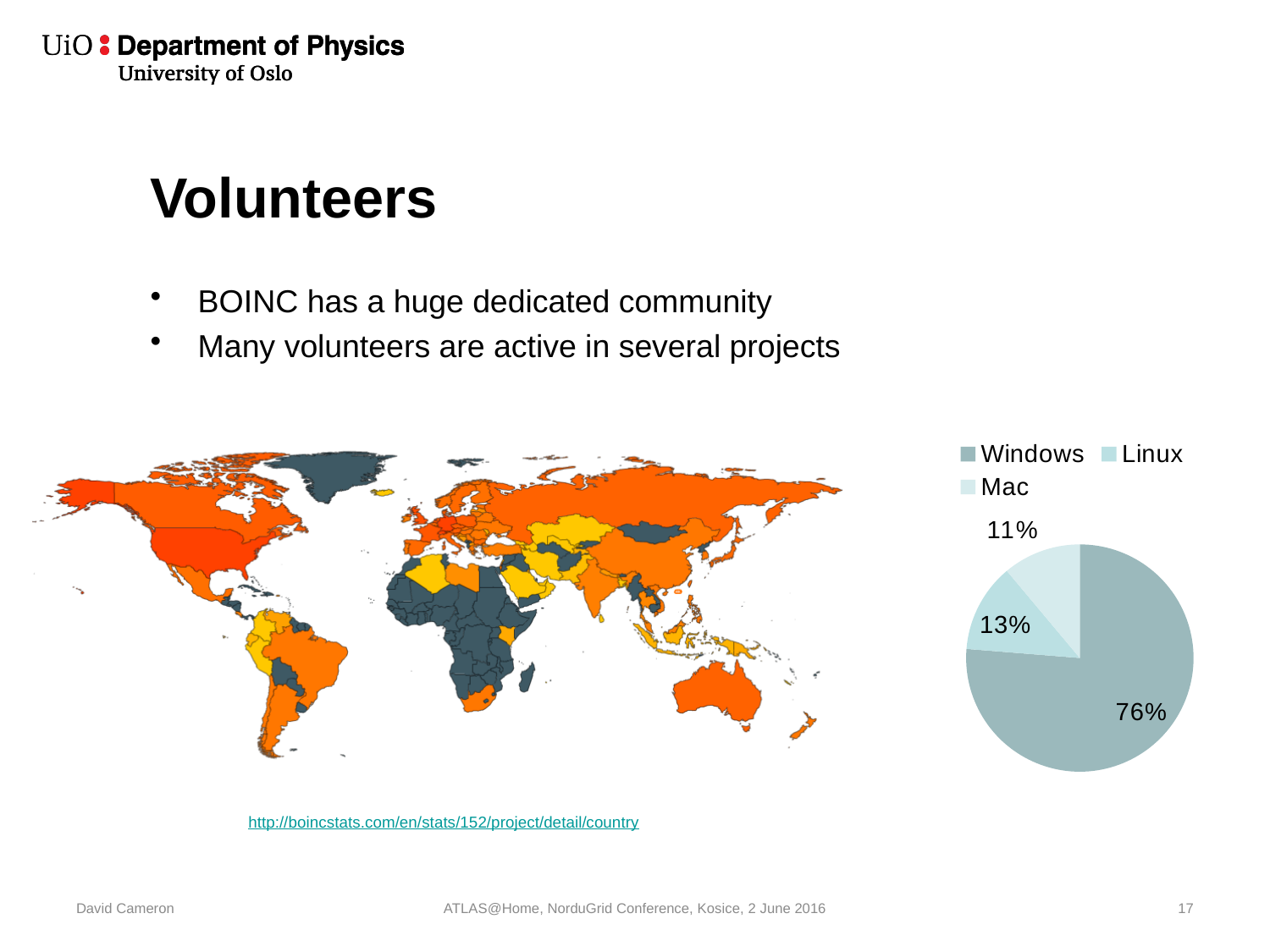
What kind of chart is shown on the right of the slide? pie chart In the pie chart, what share is labelled for Mac? 11% Which category has the largest slice in the pie chart? Windows In the pie chart, what is the difference in percentage points between Linux and Mac? 2 In the pie chart, what share is labelled for Windows? 76% In the pie chart, what share is labelled for Linux? 13% How many entries does the pie chart's legend list? 3 Which legend entry is listed first in the pie chart's legend? Windows In the pie chart, which is larger, the Windows slice or the Mac slice? Windows How many slices does the pie chart have? 3 Which category has the smallest slice in the pie chart? Mac In the pie chart, what is the difference in percentage points between Windows and Linux? 63